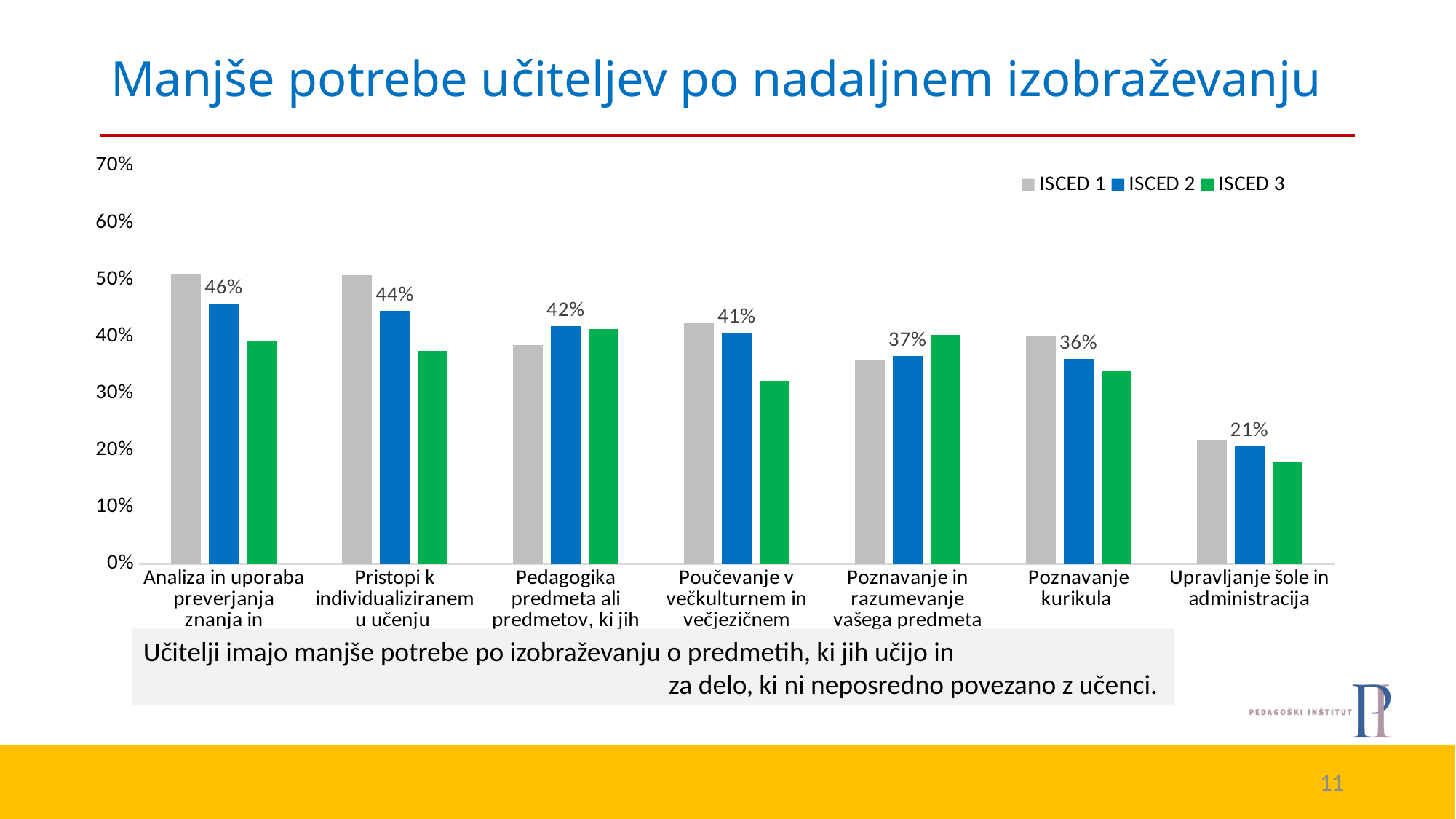
How many series does the legend list? 3 Which is larger: the ISCED 2 value for Poznavanje kurikula or for Upravljanje šole in administracija? Poznavanje kurikula What is the ISCED 2 value for Upravljanje šole in administracija? 21% Is the ISCED 1 value for Upravljanje šole in administracija greater or less than 30%? less Do the ISCED 2 values rise or fall from left to right along the x axis? fall Which category has the lowest ISCED 2 value? Upravljanje šole in administracija What is the difference between the ISCED 2 values for Pristopi k individualiziranemu učenju and Poznavanje kurikula? 8 percentage points How many categories are shown on the x axis? 7 Which category has the highest ISCED 2 value? Analiza in uporaba preverjanja znanja What is the ISCED 2 value for Poznavanje in razumevanje vašega predmeta? 37% Is the ISCED 1 value for Pristopi k individualiziranemu učenju greater or less than 40%? greater What is the ISCED 2 value for Poznavanje kurikula? 36%